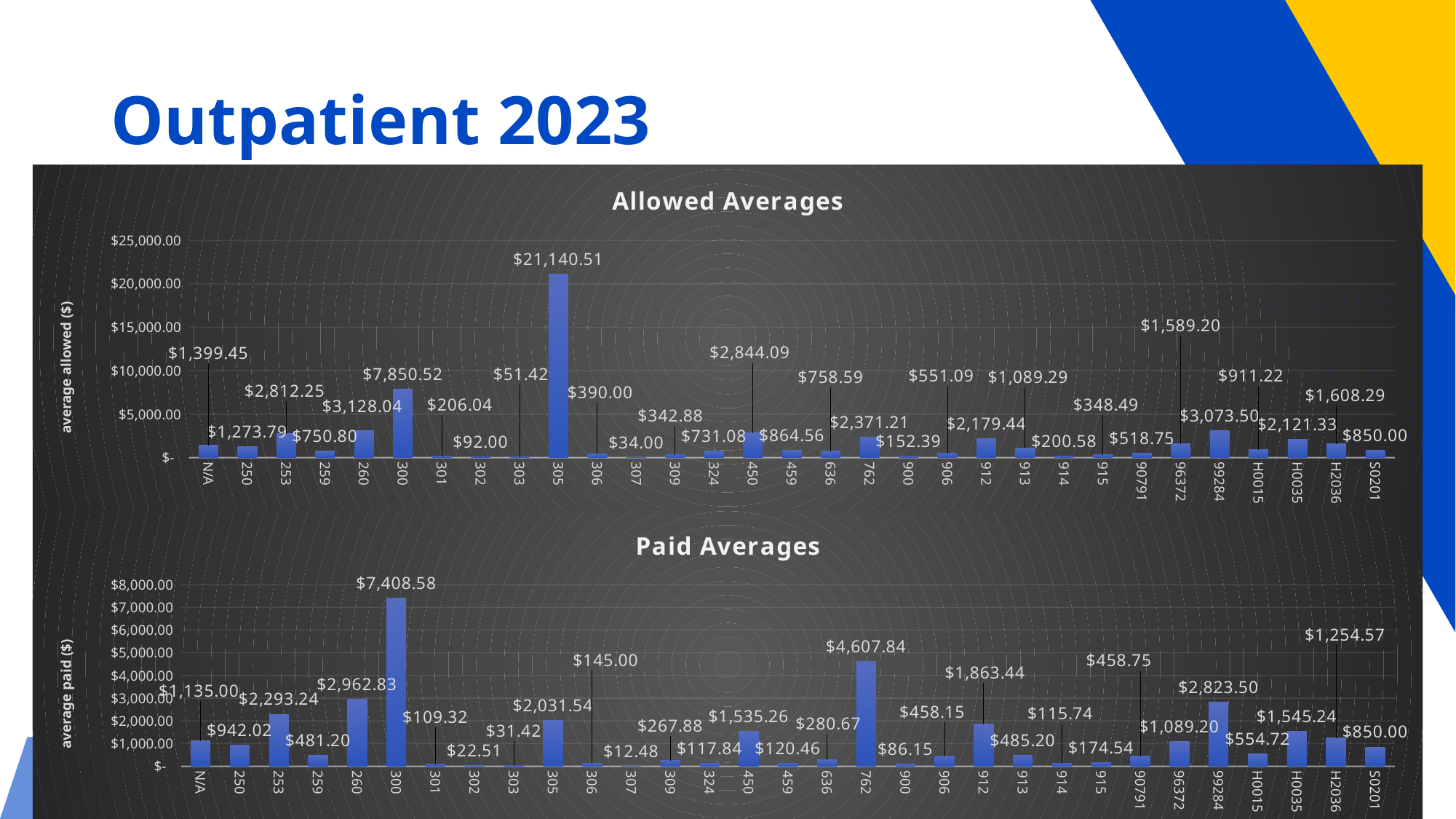
What is the difference between the value for category 300 in the Allowed Averages chart and the value for category 300 in the Paid Averages chart? $441.94 How many categories are shown on the x axis of the Paid Averages chart? 31 In the Allowed Averages chart, what is the value for category 307? $34.00 In the Allowed Averages chart, what is the value for category 305? $21,140.51 In the Paid Averages chart, which category has the highest value? 300 In the Allowed Averages chart, is the value for category 305 greater or less than $20,000.00? greater In the Paid Averages chart, which category has the lowest value? 307 In the Paid Averages chart, what is the value for category 762? $4,607.84 In the Allowed Averages chart, which category has the highest value? 305 In the Paid Averages chart, which is larger: the value for 762 or the value for 305? 762 What kind of chart is the Allowed Averages chart? bar chart In the Paid Averages chart, what is the value for category 300? $7,408.58